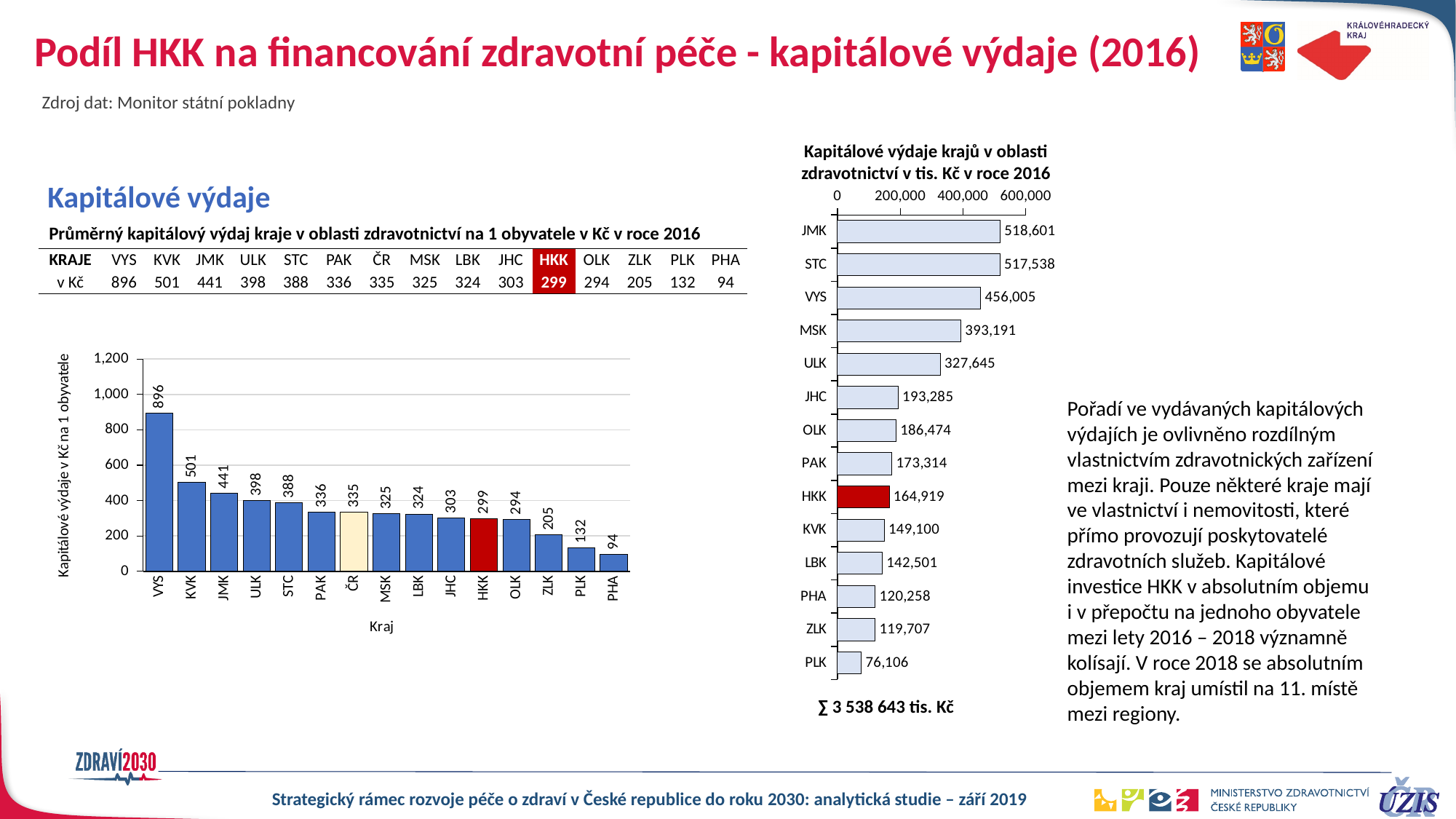
In the left chart (Kapitálové výdaje v Kč na 1 obyvatele), which region has the highest value? VYS In the left chart (Kapitálové výdaje v Kč na 1 obyvatele), do the values rise or fall from left to right? fall In the right chart (Kapitálové výdaje krajů v oblasti zdravotnictví v tis. Kč v roce 2016), how many regions are plotted? 14 In the left chart (Kapitálové výdaje v Kč na 1 obyvatele), what is the value for HKK? 299 In the right chart (Kapitálové výdaje krajů v oblasti zdravotnictví v tis. Kč v roce 2016), which region has the lowest value? PLK In the left chart (Kapitálové výdaje v Kč na 1 obyvatele), how many bars are plotted? 15 In the right chart (Kapitálové výdaje krajů v oblasti zdravotnictví v tis. Kč v roce 2016), which is larger, the value for MSK or the value for ULK? MSK In the left chart (Kapitálové výdaje v Kč na 1 obyvatele), which region has the lowest value? PHA In the left chart (Kapitálové výdaje v Kč na 1 obyvatele), what is the difference between the values for VYS and KVK? 395 In the right chart (Kapitálové výdaje krajů v oblasti zdravotnictví v tis. Kč v roce 2016), which region has the highest value? JMK In the right chart (Kapitálové výdaje krajů v oblasti zdravotnictví v tis. Kč v roce 2016), what is the value for HKK? 164,919 What type of chart is the right chart (Kapitálové výdaje krajů v oblasti zdravotnictví v tis. Kč v roce 2016)? bar chart